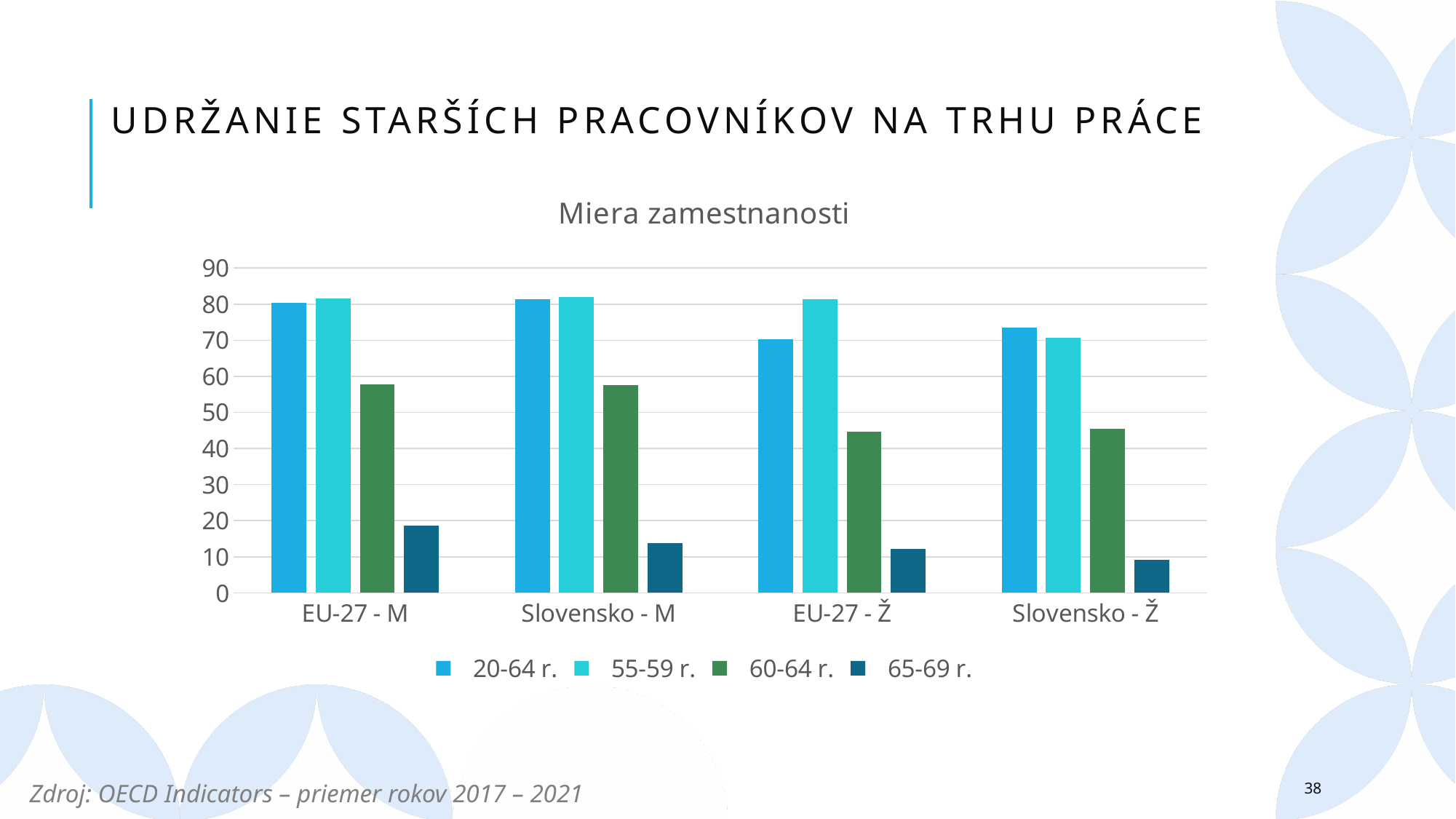
Which category has the lowest value for the 65-69 r. series? Slovensko - Ž Is the value for 60-64 r. in Slovensko - M greater or less than 50? greater Which is larger for 65-69 r.: EU-27 - M or Slovensko - Ž? EU-27 - M Which series is shown in dark green in the chart? 60-64 r. How many series does the legend of the chart list? 4 What kind of chart is shown on the slide? bar chart What is the title of the chart? Miera zamestnanosti How many categories are shown on the x axis of the chart? 4 Is the value for 65-69 r. in EU-27 - M greater or less than 10? greater Is the value for 60-64 r. in EU-27 - Ž greater or less than 50? less For EU-27 - Ž, which is larger: 20-64 r. or 55-59 r.? 55-59 r.